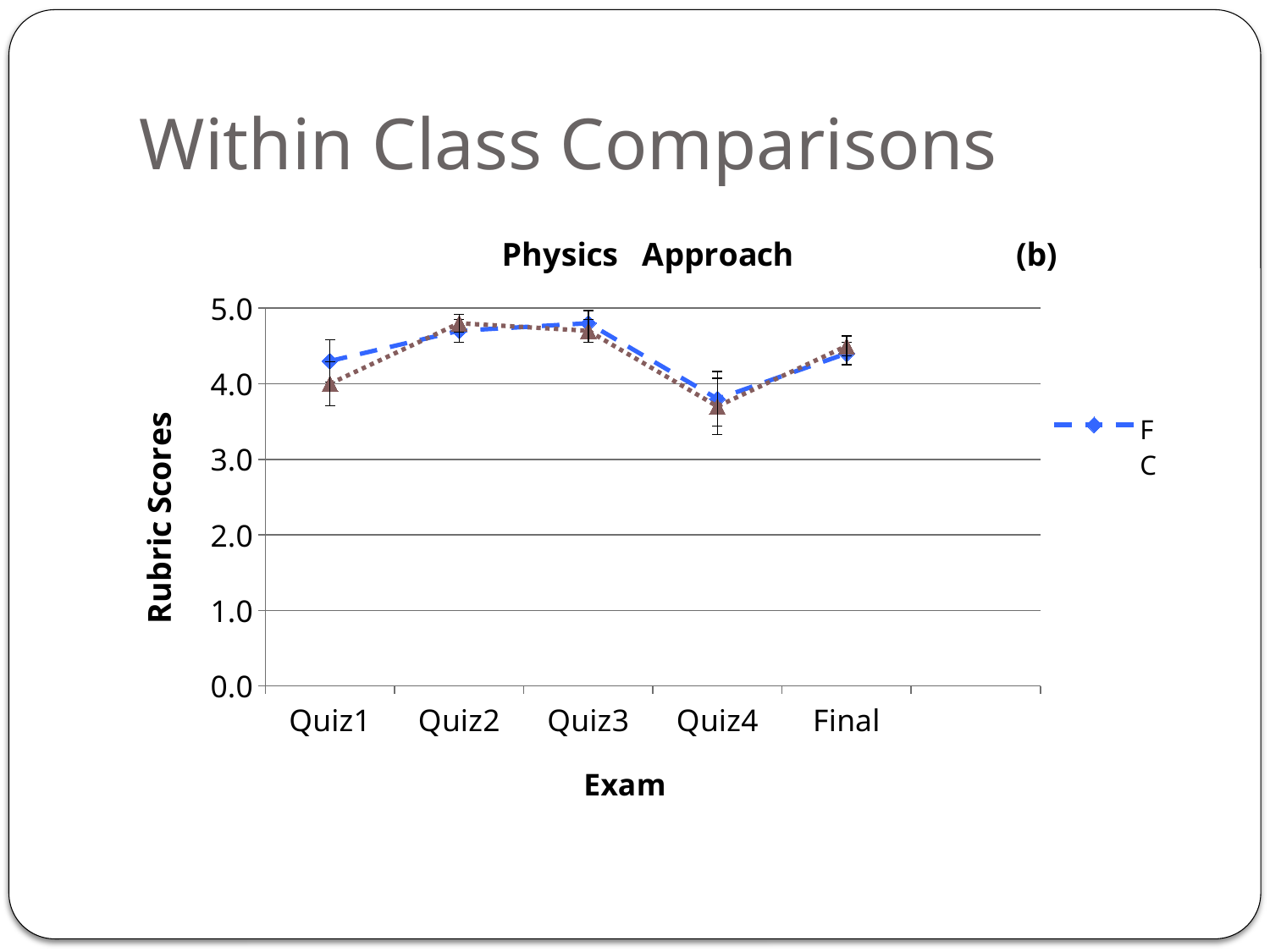
Do the rubric scores for series F rise or fall from Quiz3 to Quiz4? fall For which exam does series F have its lowest rubric score? Quiz4 What is the title of the chart? Physics Approach (b) At Quiz1, which series has the higher rubric score, F or C? F Is the value for series F at Quiz1 greater or less than 4.0? greater Is the value for series F at Quiz4 greater or less than 4.0? less For which exam does series C have its lowest rubric score? Quiz4 How many exams are plotted along the x axis? 5 How many series does the legend list? 2 What is the label of the y axis? Rubric Scores Is the value for series C at Quiz2 greater or less than 4.0? greater What kind of chart is shown on the slide? Line chart